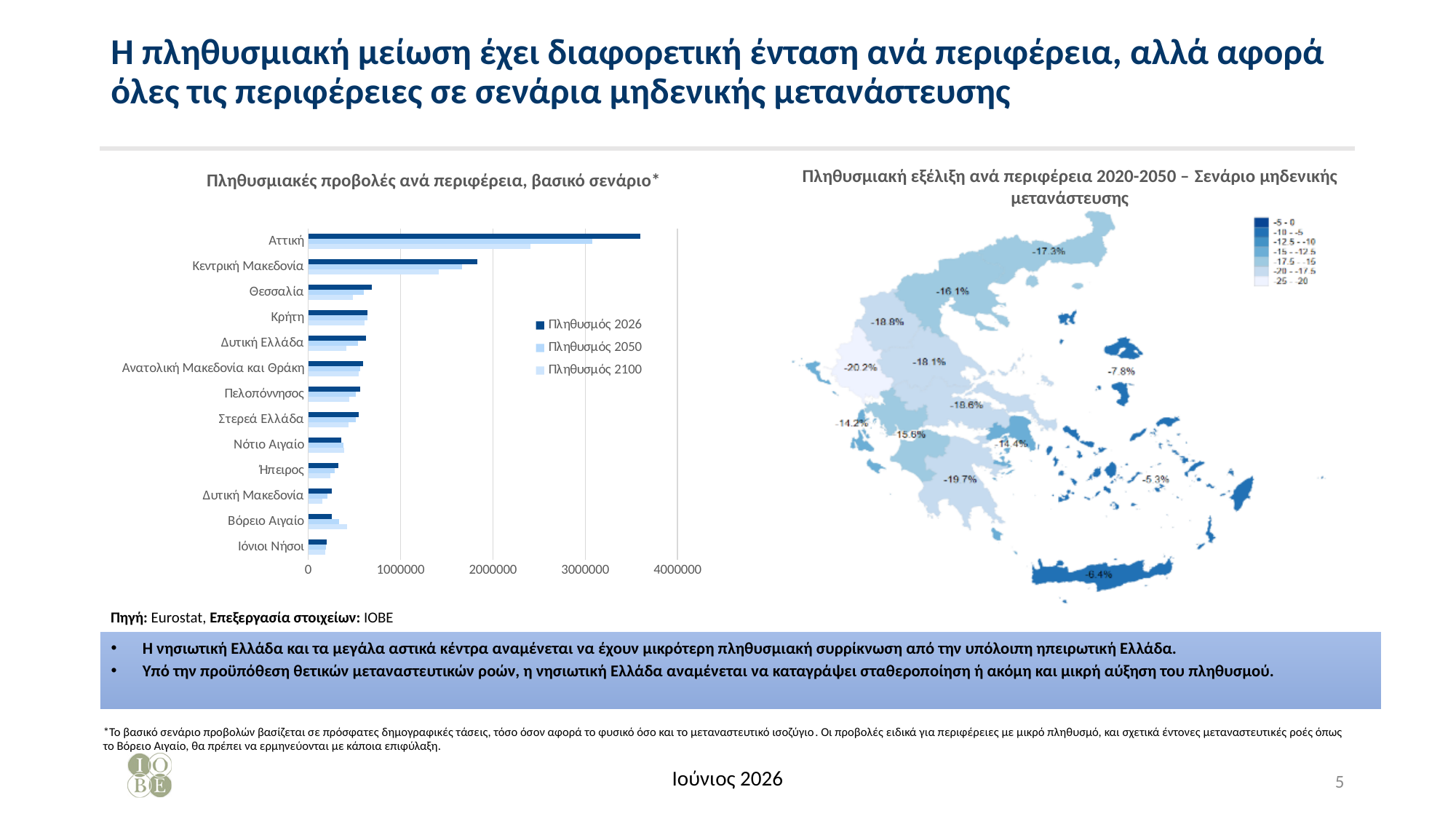
In the left bar chart, is the Πληθυσμός 2026 value for Θεσσαλία greater or less than 1000000? less In the left bar chart, is the Πληθυσμός 2026 value for Αττική greater or less than 3000000? greater In the left bar chart, how many series does the legend list? 3 In the left bar chart, how many regions (categories) are listed on the vertical axis? 13 In the left bar chart, which region has the highest value for Πληθυσμός 2026? Αττική What are the three legend entries of the left bar chart? Πληθυσμός 2026, Πληθυσμός 2050, Πληθυσμός 2100 What type of chart is the left chart titled 'Πληθυσμιακές προβολές ανά περιφέρεια, βασικό σενάριο*'? Bar chart In the left bar chart, which region has the larger Πληθυσμός 2026 value: Αττική or Κεντρική Μακεδονία? Αττική In the left bar chart, does the population of Αττική rise or fall from the 2026 series to the 2100 series? Fall On the right map, what percentage is shown on Crete (the large southern island)? -6.4% In the left bar chart, is the Πληθυσμός 2026 value for Κεντρική Μακεδονία greater or less than 2000000? less In the left bar chart, for Βόρειο Αιγαίο, which is larger: Πληθυσμός 2026 or Πληθυσμός 2100? Πληθυσμός 2100